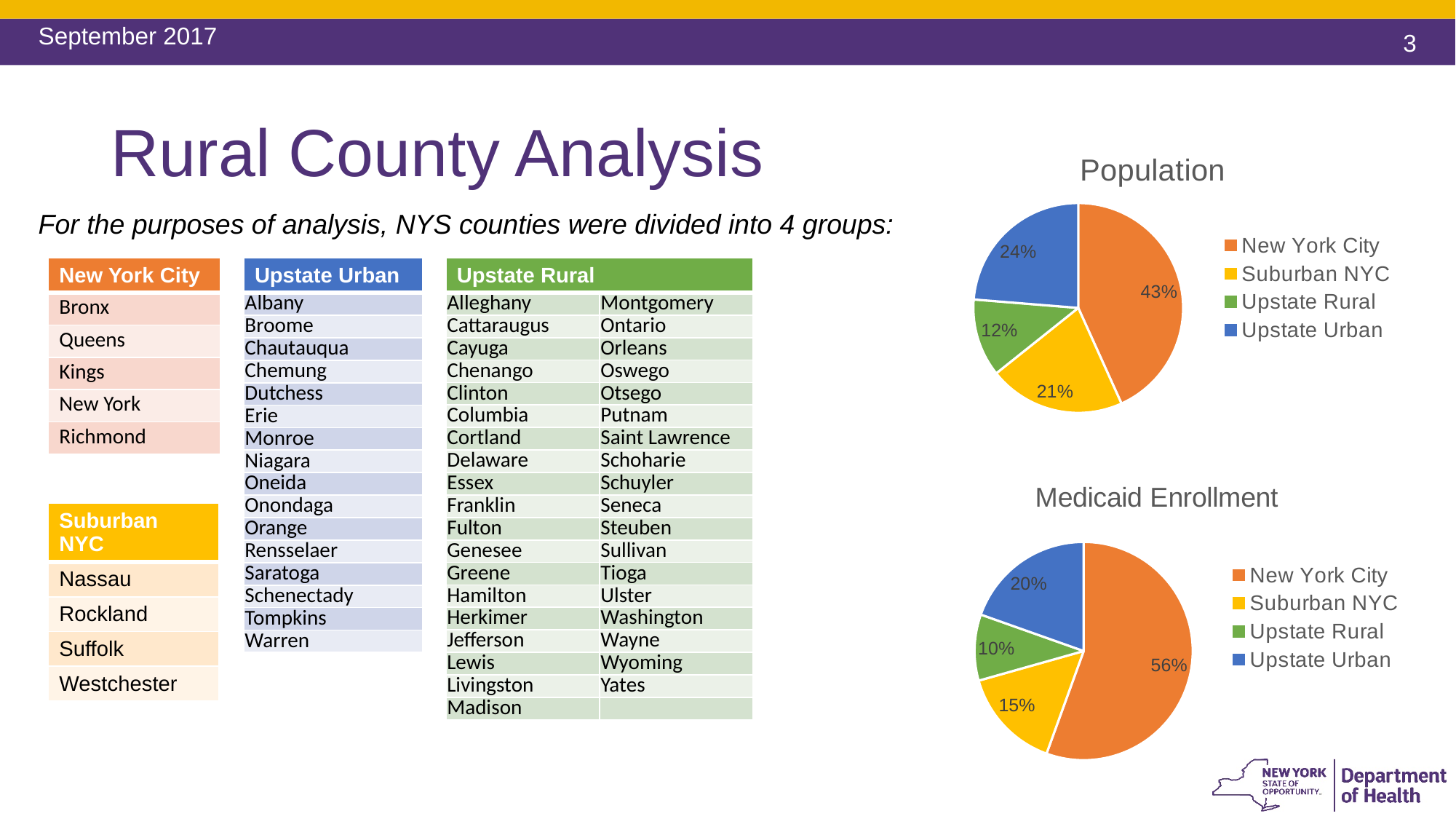
What kind of chart is the Medicaid Enrollment chart? Pie chart In the Population chart, what is the value for Upstate Rural? 12% In the Population chart, which group has the smallest slice? Upstate Rural In the Population chart, what share of the pie does New York City have? 43% How many entries does the legend of the Medicaid Enrollment chart list? 4 In the Medicaid Enrollment chart, what is the difference between the New York City and Upstate Urban values? 36% In the Medicaid Enrollment chart, which group has the largest slice? New York City In the Population chart, which is larger, Suburban NYC or Upstate Urban? Upstate Urban How many slices does the Population pie chart have? 4 In the Medicaid Enrollment chart, what colour is the Upstate Rural slice? Green In the Medicaid Enrollment chart, what is the value for Suburban NYC? 15% In the Population chart, what is the difference between the Upstate Urban and Upstate Rural values? 12%